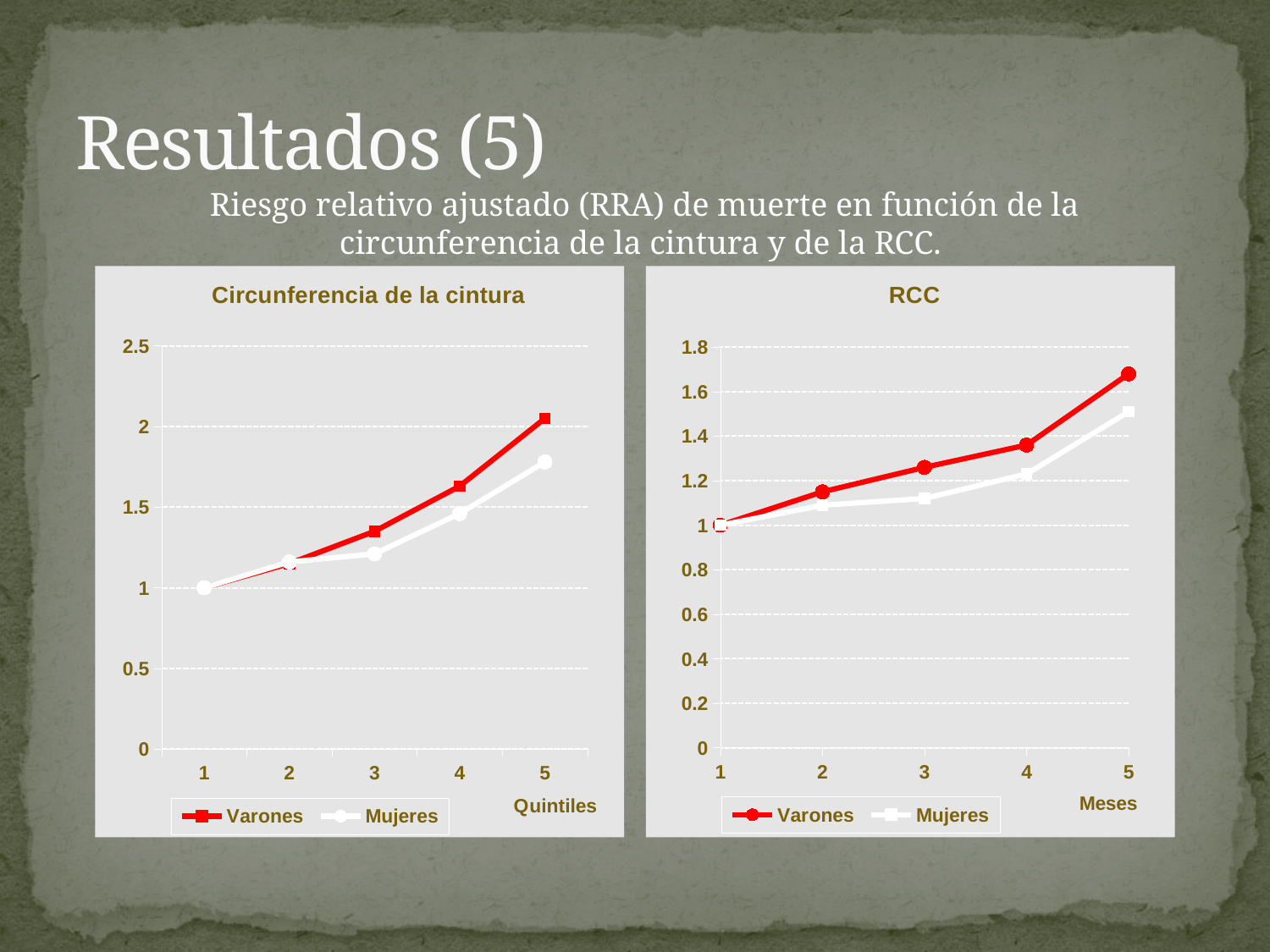
In the 'RCC' chart, what is the value for Mujeres at mes 1? 1 What is the x-axis label of the 'RCC' chart? Meses What kind of chart is the 'Circunferencia de la cintura' chart? line chart How many series does the legend of the 'RCC' chart list? 2 In the 'Circunferencia de la cintura' chart, is the value for Mujeres at quintile 5 greater or less than 1.5? greater In the 'RCC' chart, do the values for Varones rise or fall from mes 1 to mes 5? rise In the 'Circunferencia de la cintura' chart, is the value for Mujeres at quintile 3 greater or less than 1.5? less In the 'Circunferencia de la cintura' chart, what is the value for Varones at quintile 1? 1 In the 'RCC' chart, is the value for Varones at mes 3 greater or less than 1.4? less In the 'Circunferencia de la cintura' chart, which series has the higher value at quintile 5, Varones or Mujeres? Varones How many quintiles are plotted on the x axis of the 'Circunferencia de la cintura' chart? 5